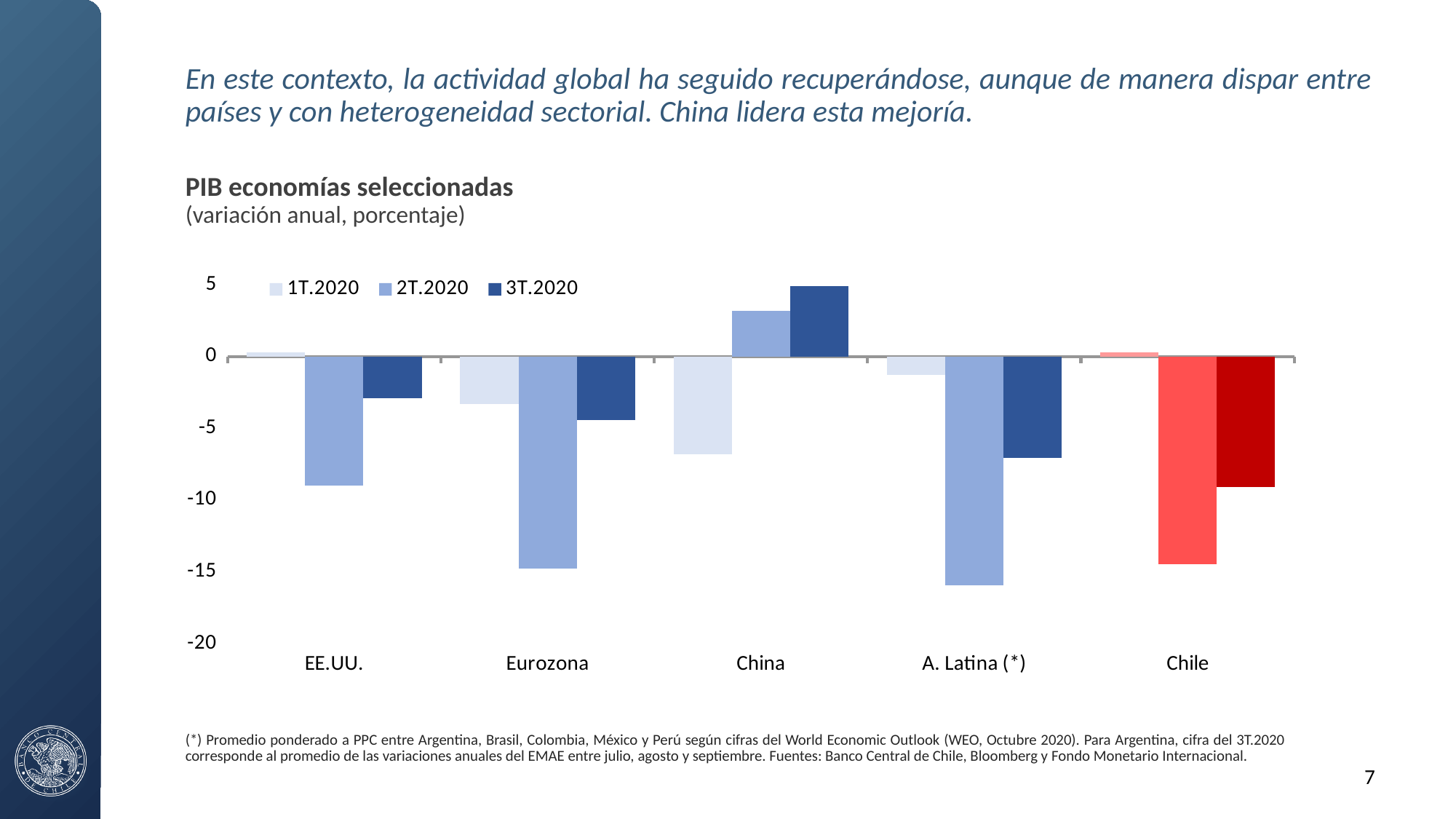
What kind of chart is shown on the slide? bar chart How many series does the legend of the chart list? 3 Is the 2T.2020 value for EE.UU. greater or less than -5? less Which economy has the lowest 2T.2020 value in the chart? A. Latina (*) For China, which is larger: the 2T.2020 value or the 3T.2020 value? 3T.2020 Which economy has the highest 3T.2020 value in the chart? China How many economies (categories) are shown on the x axis of the chart? 5 Is the 3T.2020 value for China greater or less than 0? greater What is the title of the chart? PIB economías seleccionadas Is the 2T.2020 value for Eurozona greater or less than -10? less For China, do the values rise or fall from 1T.2020 to 3T.2020? rise